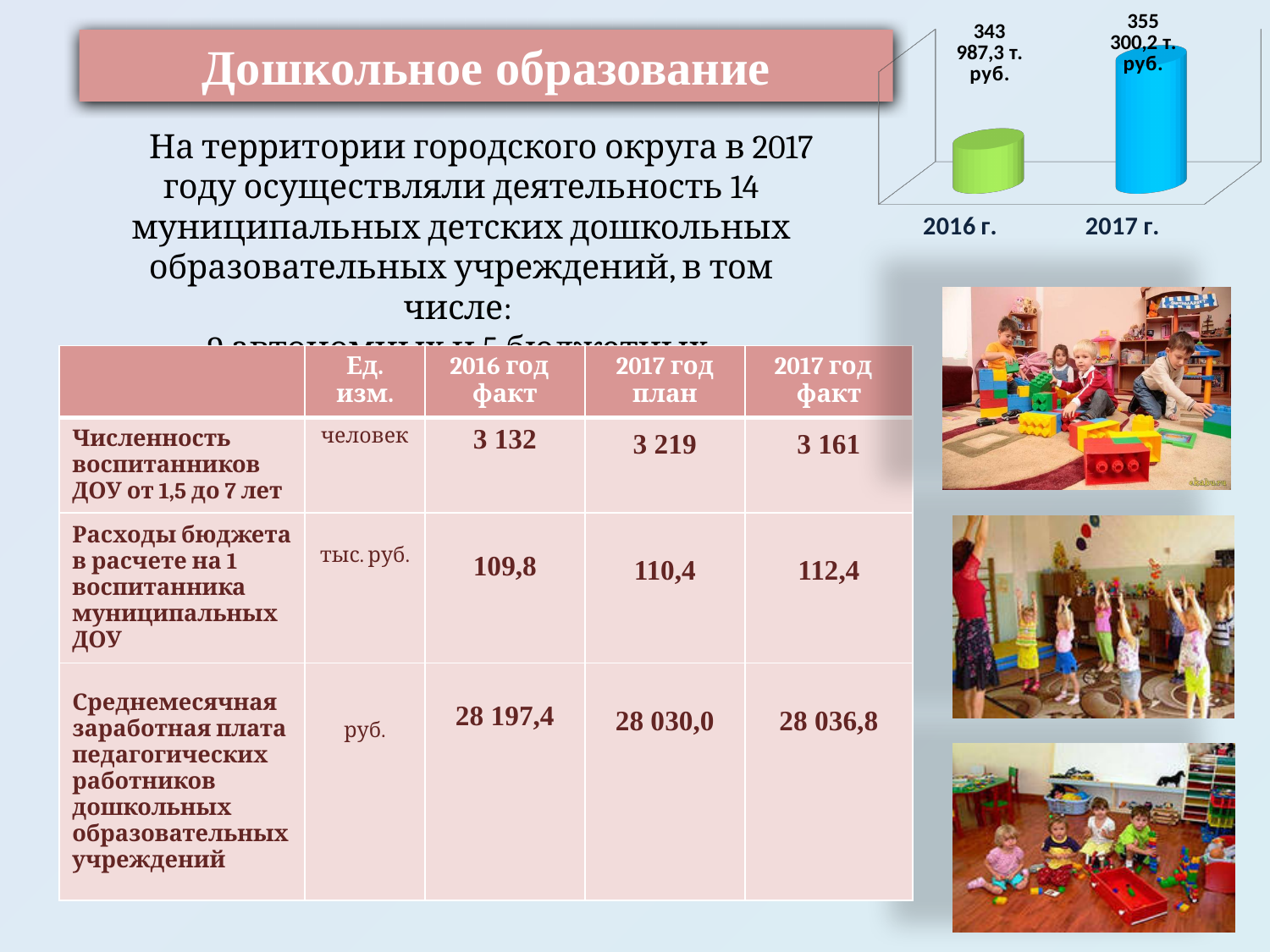
Which year has the higher value in the chart? 2017 г. What kind of chart is shown in the top right of the slide? bar chart What value is shown for 2016 г. in the chart? 343 987,3 т. руб. By how much does the 2017 г. value exceed the 2016 г. value in the chart? 11 312,9 т. руб. Which year has the lower value in the chart? 2016 г. What value is shown for 2017 г. in the chart? 355 300,2 т. руб. Does the value rise or fall from 2016 г. to 2017 г. in the chart? rise How many categories (years) are plotted in the chart? 2 What colour is the bar for 2017 г. in the chart? blue What colour is the bar for 2016 г. in the chart? green Is the value for 2017 г. larger or smaller than the value for 2016 г.? larger